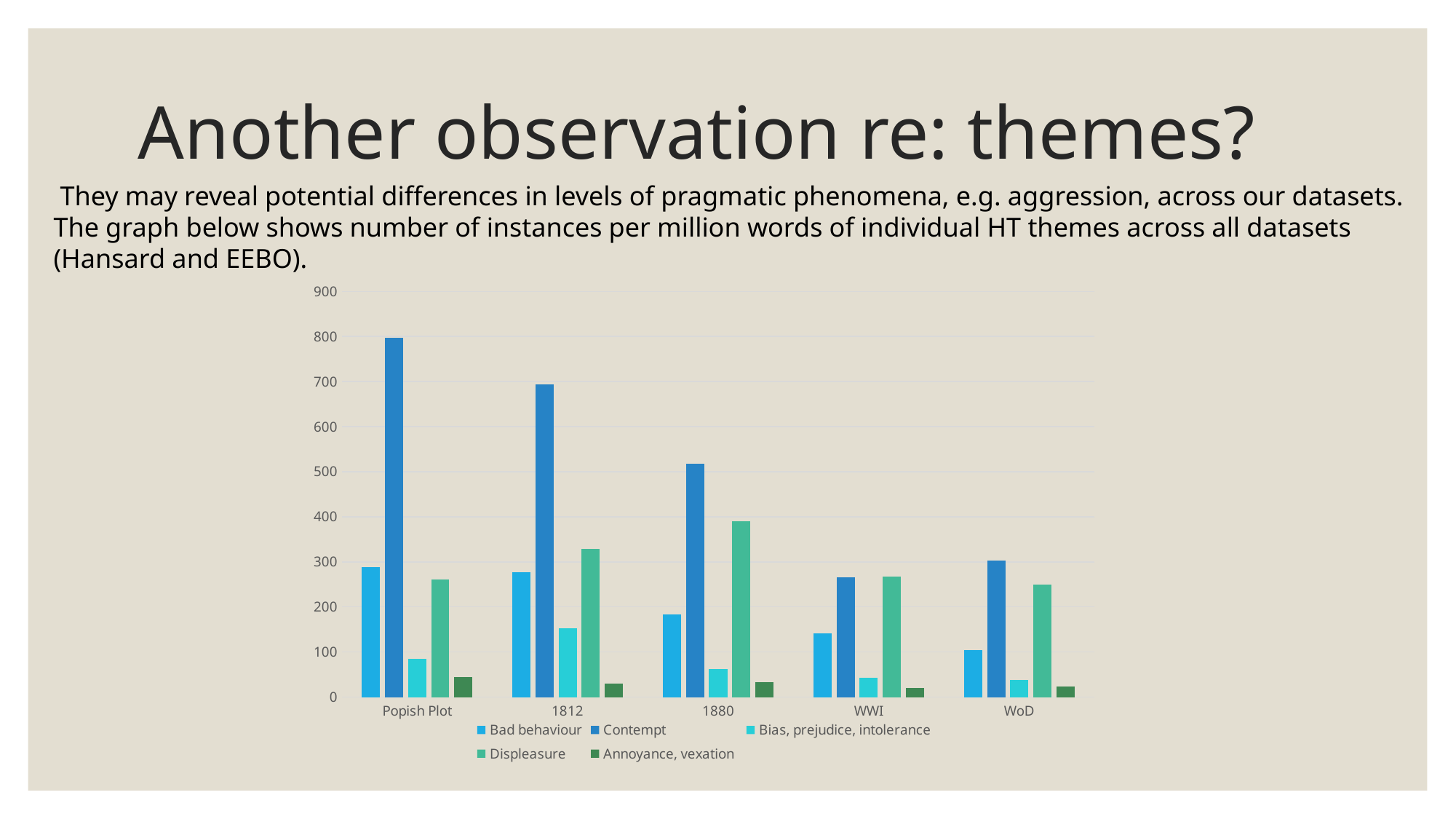
In which category is the Contempt value highest? Popish Plot Does the Bad behaviour series rise or fall from Popish Plot to WoD? fall Which series has the lowest value for Popish Plot? Annoyance, vexation For 1880, which is larger: Displeasure or Bad behaviour? Displeasure Which is larger: Contempt for 1812 or Contempt for 1880? 1812 What kind of chart is shown on the slide? bar chart Is the Bad behaviour value for WoD greater or less than 200? less Is the Contempt value for Popish Plot greater or less than 700? greater Is the Contempt value for 1880 greater or less than 400? greater In which category is the Displeasure value highest? 1880 How many categories are shown on the x axis? 5 How many series does the legend list? 5